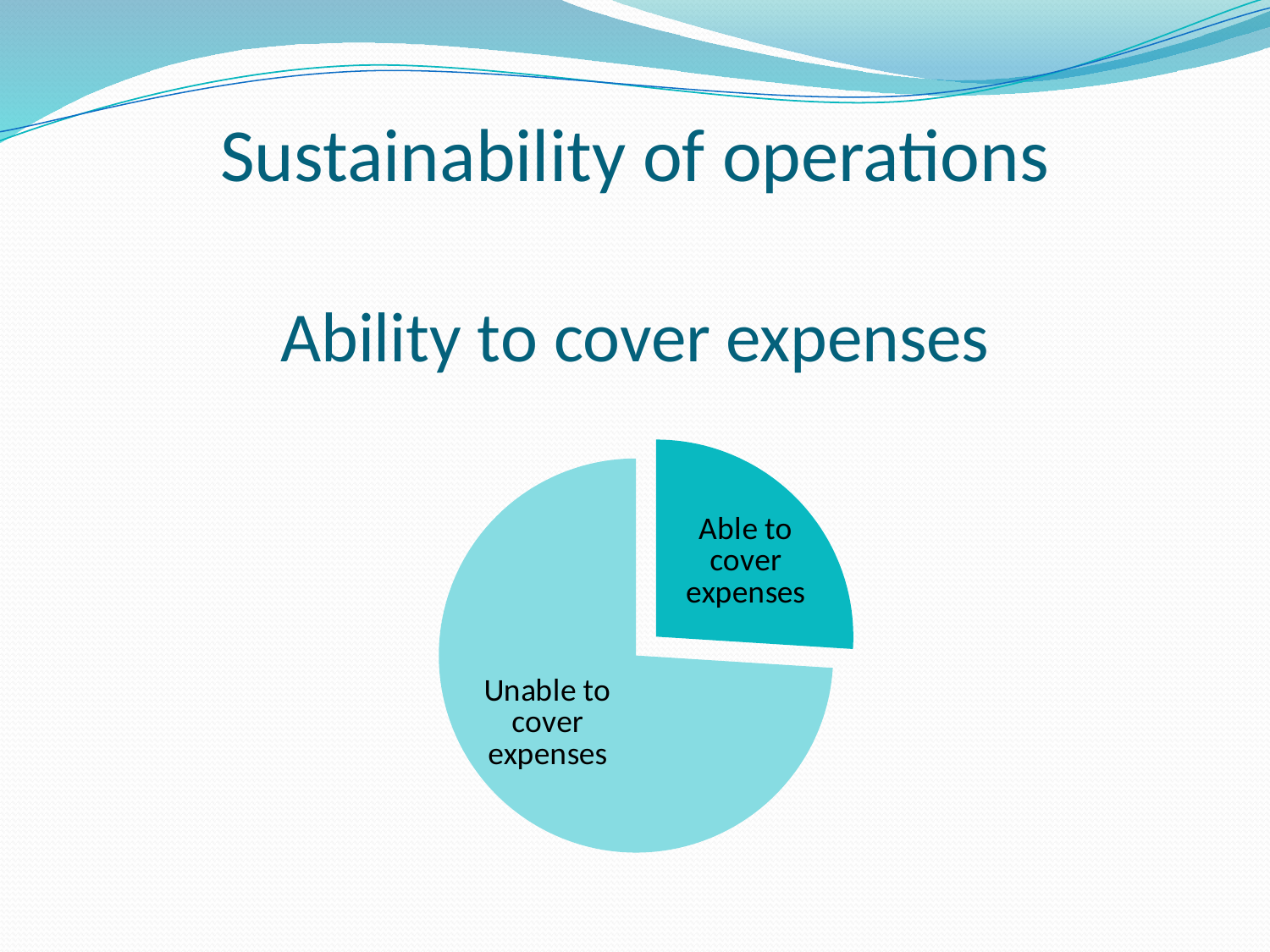
Which slice of the pie chart is pulled out (exploded) from the rest of the pie? Able to cover expenses What is the title shown above the pie chart? Ability to cover expenses Does the "Unable to cover expenses" slice take up more or less than half of the pie? more Which slice of the pie chart is the smallest? Able to cover expenses Which slice of the pie chart is the largest? Unable to cover expenses Which slice is larger: "Able to cover expenses" or "Unable to cover expenses"? Unable to cover expenses What kind of chart is shown on the slide? pie chart How many slices does the pie chart have? 2 Does the "Able to cover expenses" slice take up more or less than half of the pie? less